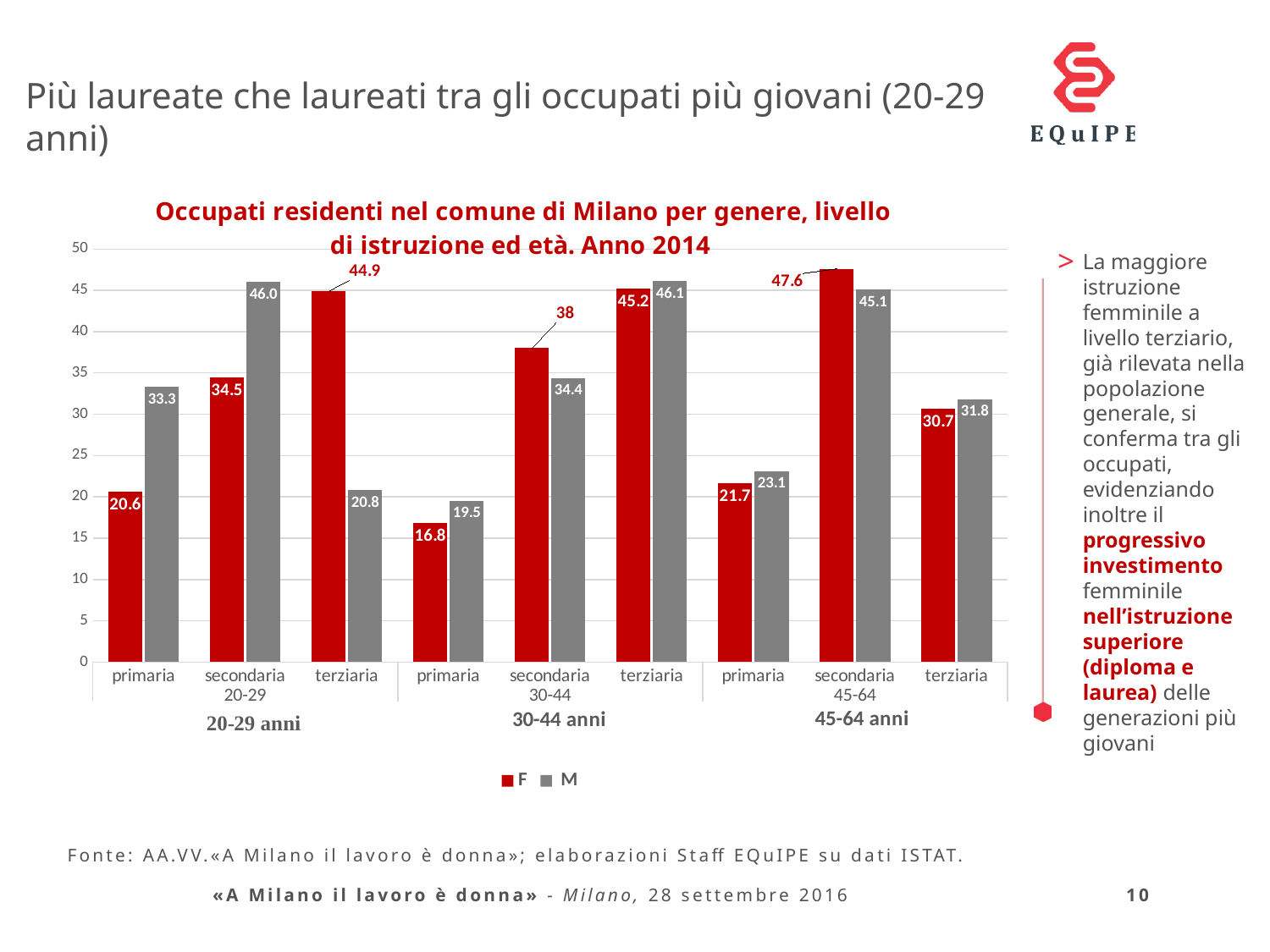
What is the difference between the F and M values for terziaria in the 20-29 age group? 24.1 What is the value for F (female) for terziaria in the 20-29 age group? 44.9 Which category has the lowest F value across the chart? primaria 30-44 How many categories are shown on the x axis? 9 How many series does the legend list? 2 What colour represents the F series? Red Which category has the highest M value across the chart? terziaria 30-44 What is the value for M (male) for secondaria in the 20-29 age group? 46.0 What kind of chart is this? Bar chart For secondaria in the 30-44 age group, which is larger, the F value or the M value? F What is the value for M for primaria in the 30-44 age group? 19.5 What is the value for F for secondaria in the 45-64 age group? 47.6